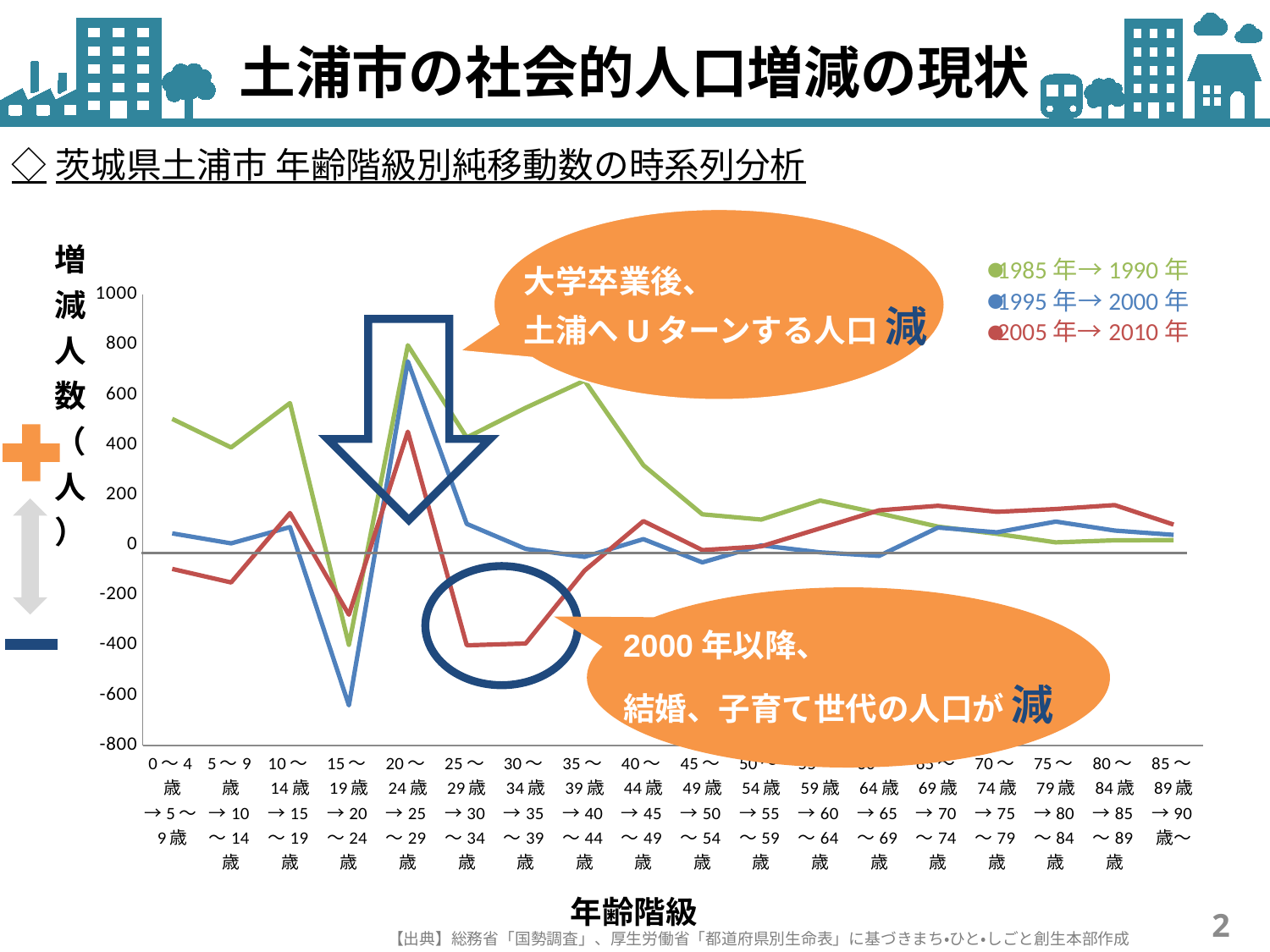
Which age group has the highest value for the 1985年→1990年 series? 20～24歳→25～29歳 What colour is the line for the 2005年→2010年 series? red How many age-group categories are plotted along the x axis? 18 At 15～19歳→20～24歳, which series has the larger value: 1995年→2000年 or 2005年→2010年? 2005年→2010年 Which age group has the highest value for the 2005年→2010年 series? 20～24歳→25～29歳 What kind of chart is shown on the slide? line chart Is the value for 25～29歳→30～34歳 in the 2005年→2010年 series greater or less than -200? less How many series does the legend list? 3 At 20～24歳→25～29歳, which series has the larger value: 1985年→1990年 or 2005年→2010年? 1985年→1990年 Which age group has the lowest value for the 1995年→2000年 series? 15～19歳→20～24歳 Is the value for 15～19歳→20～24歳 in the 1995年→2000年 series greater or less than -400? less Is the value for 20～24歳→25～29歳 in the 1985年→1990年 series greater or less than 600? greater